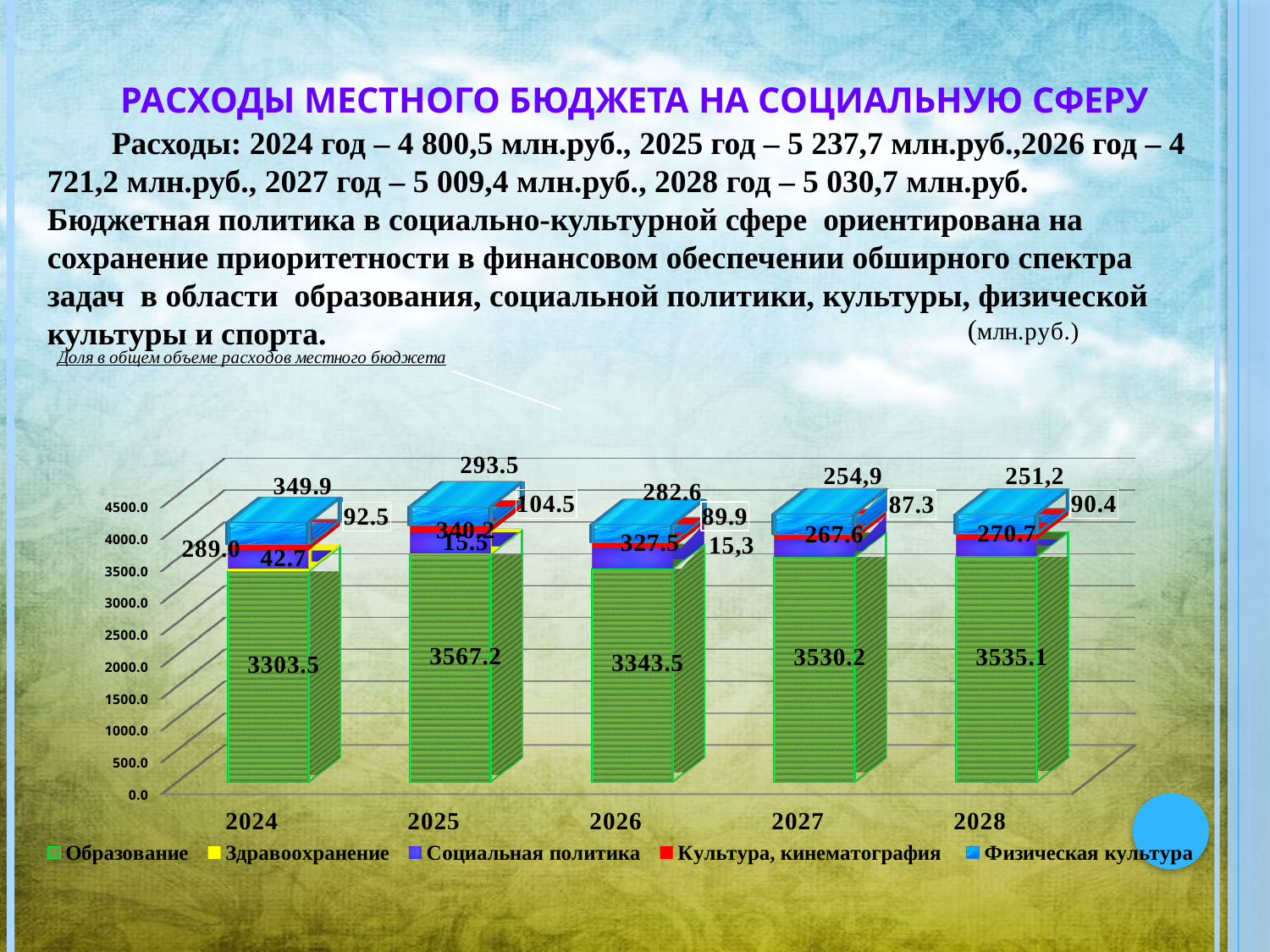
What is the value for Образование in 2025? 3567.2 What is the value for Образование in 2028? 3535.1 Which is larger, the Образование value for 2027 or for 2026? 2027 In which year is the value for Образование the highest? 2025 Which series is listed first in the chart legend? Образование What is the value for Образование in 2024? 3303.5 What kind of chart is shown on the slide? Stacked bar chart What is the difference between the Образование values for 2025 and 2024? 263.7 How many series does the chart legend list? 5 Is the value for Образование in 2026 greater or less than 3000.0? greater In which year is the value for Образование the lowest? 2024 How many years are shown on the x axis of the chart? 5